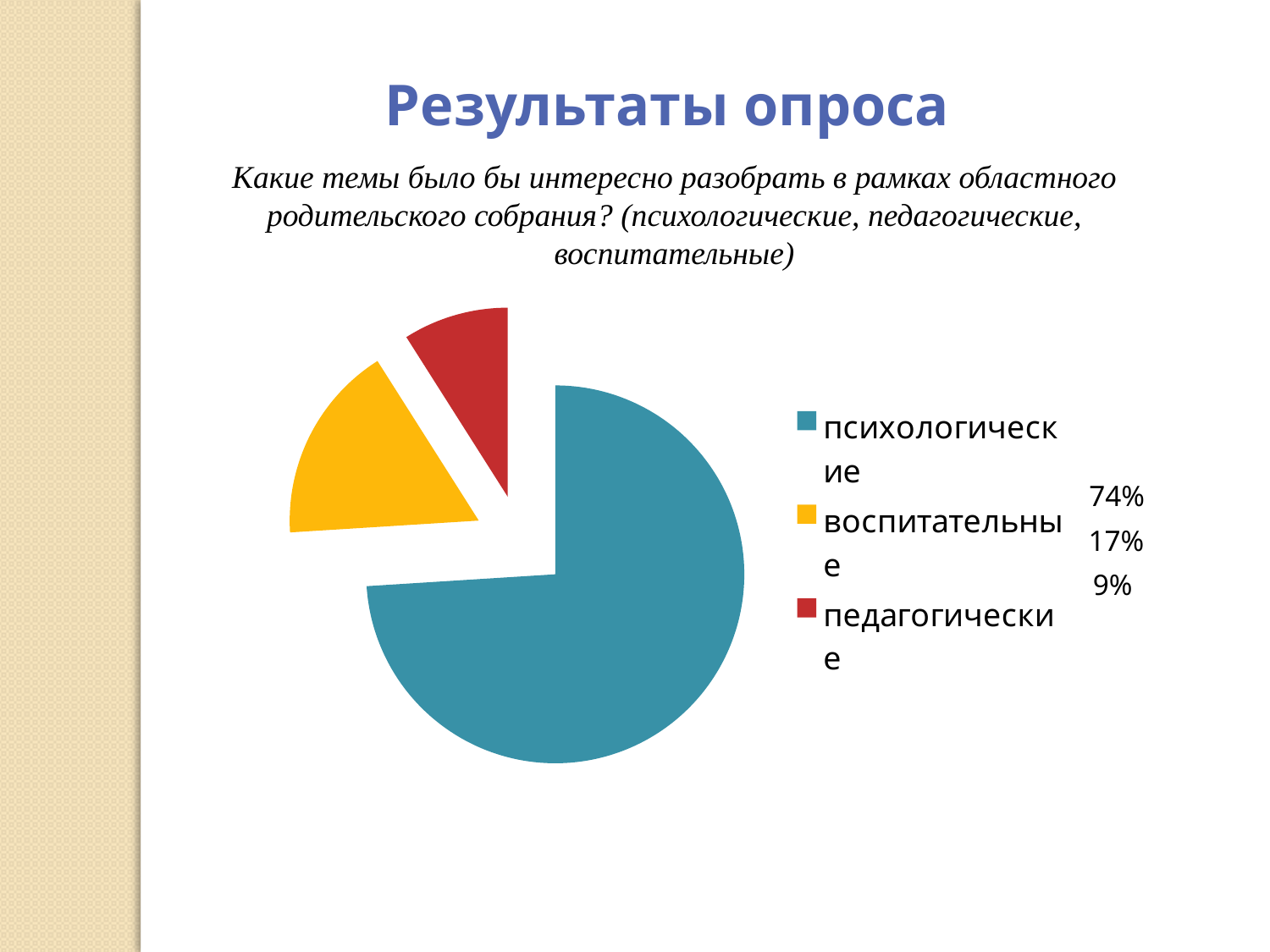
What share of the pie does the slice for педагогические represent? 9% How many slices does the pie chart have? 3 What share of the pie does the slice for психологические represent? 74% What is the difference in percentage points between the психологические and воспитательные slices? 57 Which category has the largest slice of the pie? психологические What colour is the slice for психологические? teal (blue-green) How many entries does the legend of the pie chart list? 3 What kind of chart is shown on the slide? pie chart What is the title of the slide containing the pie chart? Результаты опроса Which slice is larger, воспитательные or педагогические? воспитательные Which category has the smallest slice of the pie? педагогические What share of the pie does the slice for воспитательные represent? 17%